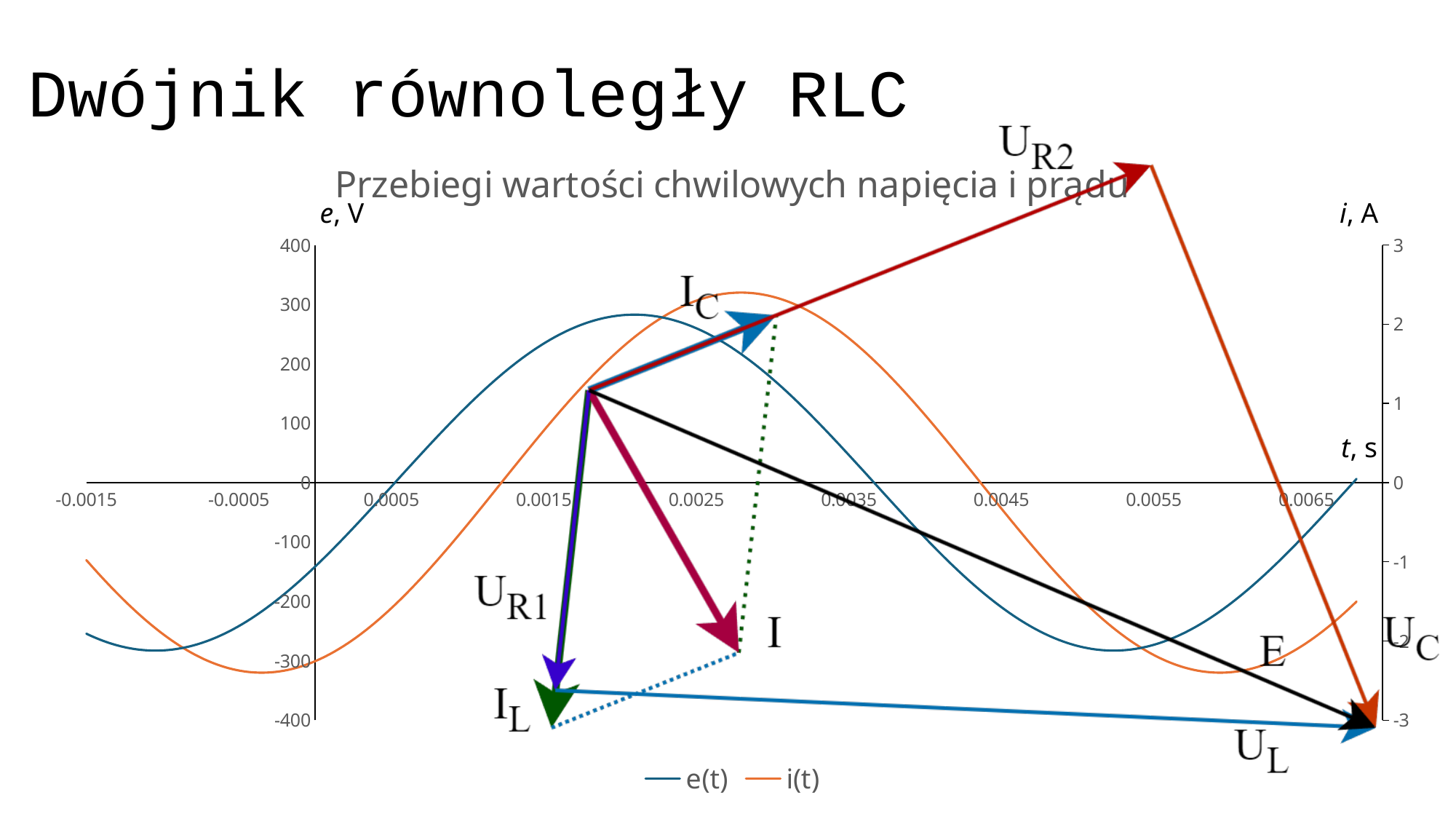
How many series does the chart legend list? 2 Is the value of e(t) at t = 0.002 greater or less than 200? greater Is the value of e(t) at t = 0.0055 greater or less than -200? less Is the value of i(t) at t = 0.0005 greater or less than 0? less Between t = 0.0005 and t = 0.002, does e(t) rise or fall? rise What are the two series named in the chart legend? e(t) and i(t) What kind of chart is shown on the slide? line chart Between t = 0.0025 and t = 0.0045, does i(t) rise or fall? fall What is the title of the chart? Przebiegi wartości chwilowych napięcia i prądu Which series reaches its first positive peak earlier along the t axis, e(t) or i(t)? e(t)